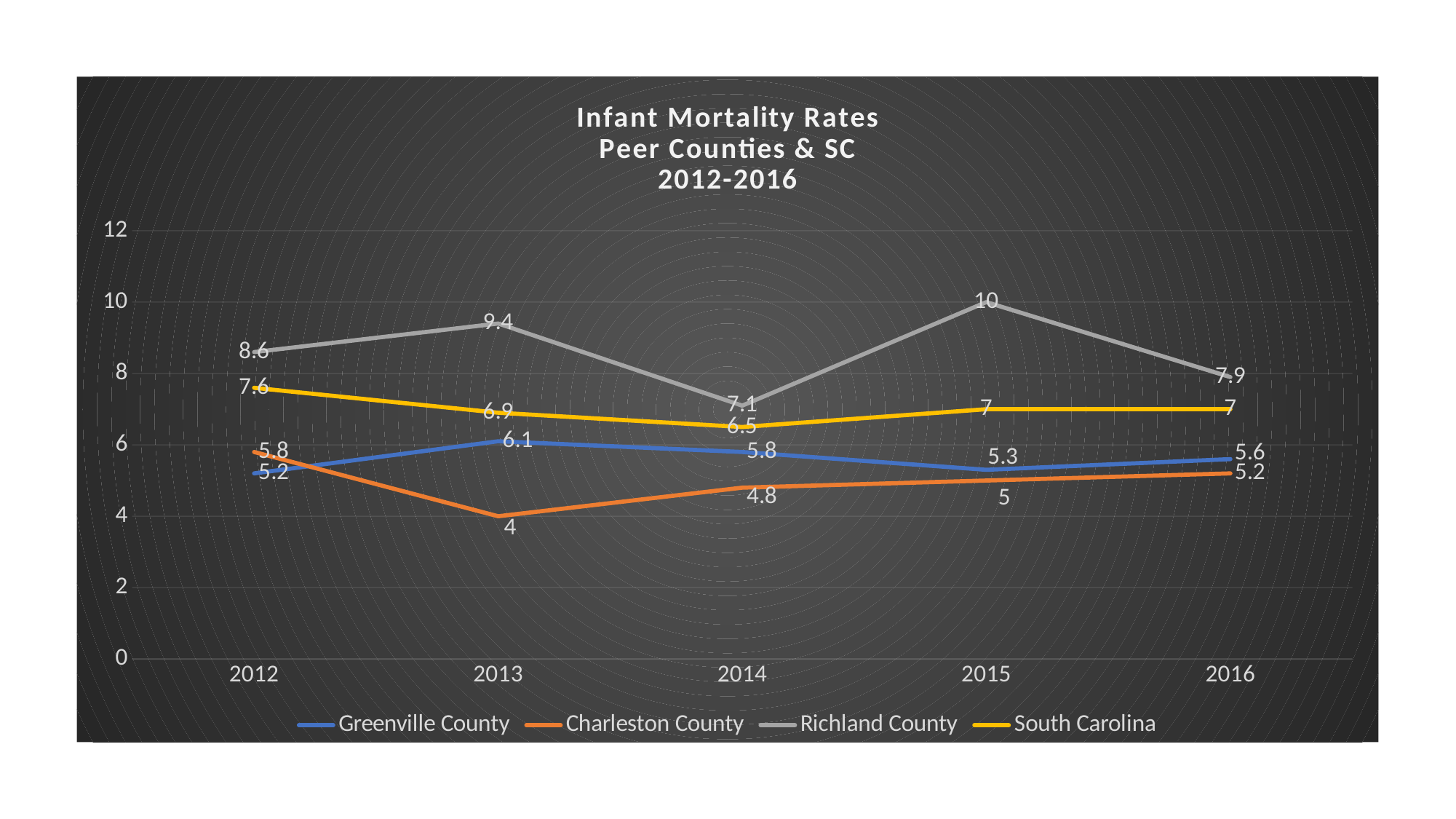
Which series is drawn in gray? Richland County How many series does the legend list? 4 Which had a higher infant mortality rate in 2012, Greenville County or Charleston County? Charleston County How many years are shown on the x axis? 5 What is the difference between Richland County's and Greenville County's infant mortality rates in 2015? 4.7 What was the infant mortality rate for Richland County in 2015? 10 What type of chart is shown on the slide? Line chart What was the infant mortality rate for Greenville County in 2016? 5.6 In which year did Charleston County have its lowest infant mortality rate? 2013 What was the infant mortality rate for South Carolina in 2012? 7.6 In which year did Richland County have its highest infant mortality rate? 2015 What was the infant mortality rate for Charleston County in 2013? 4